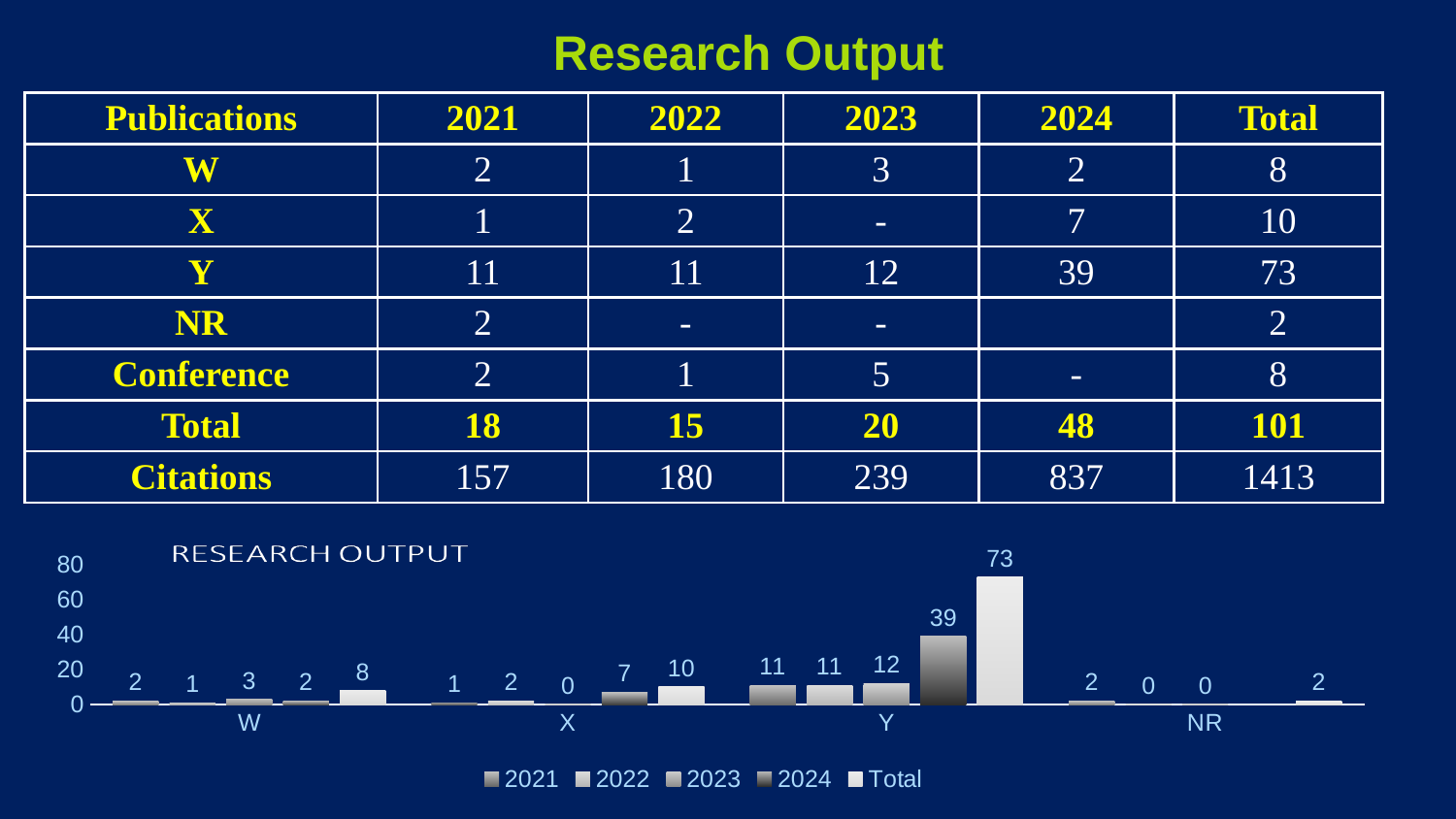
What is the 2024 value for X in the chart? 7 What is the 2023 value for W in the chart? 3 Which category has the highest Total value in the chart? Y Which category has the lowest Total value in the chart? NR What is the difference between the 2024 value and the 2023 value for Y in the chart? 27 How many series does the chart legend list? 5 What type of chart is shown on the slide? bar chart How many categories are shown on the x axis of the chart? 4 Is the 2024 value for Y larger than the 2024 value for X in the chart? Yes Is the Total value for Y greater or less than 60 in the chart? greater What is the Total value for Y in the chart? 73 What is the title of the chart? RESEARCH OUTPUT